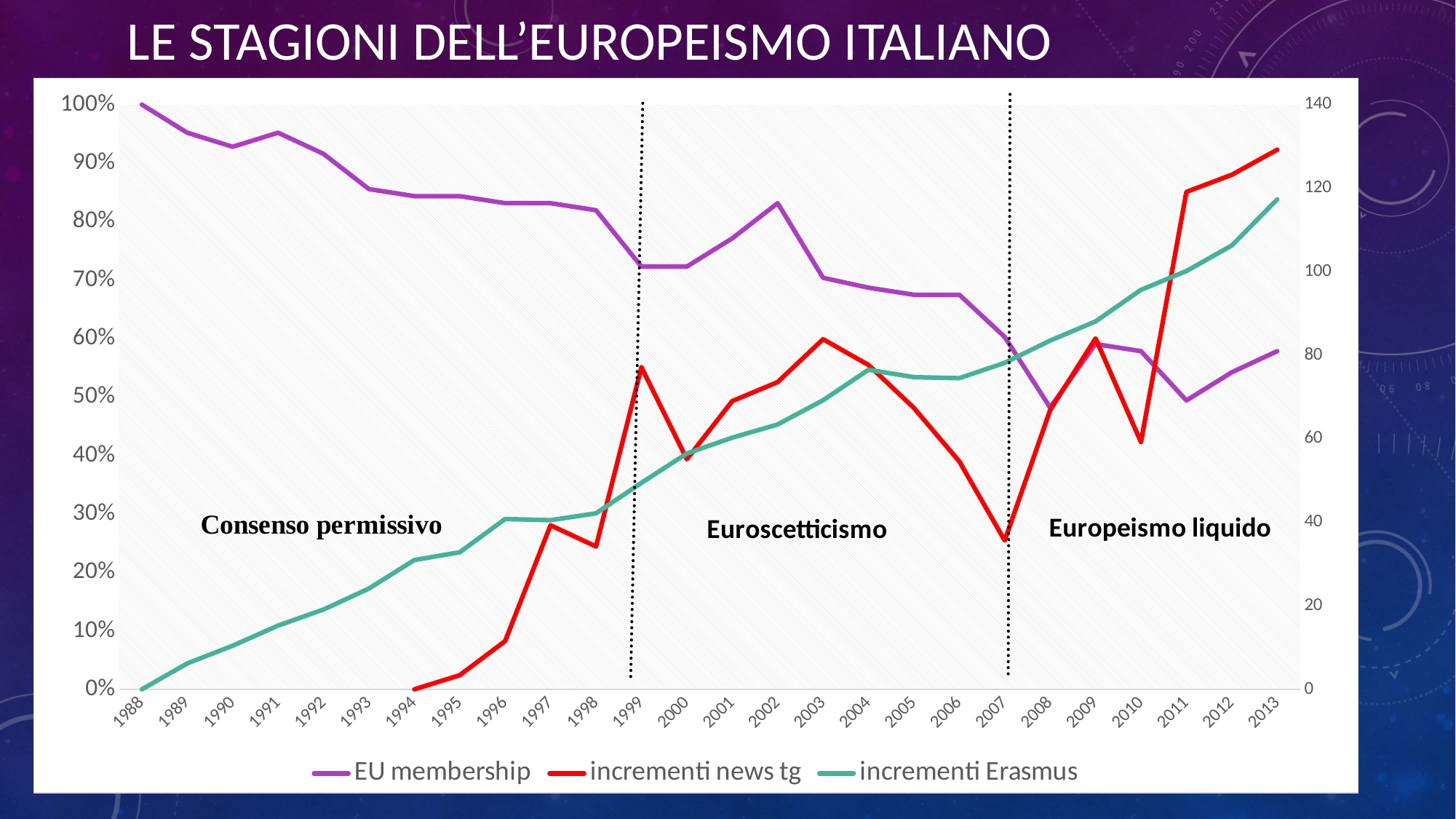
In which year is EU membership at its highest? 1988 What is the value of incrementi Erasmus in 1988 on the right axis? 0 Is the value for EU membership in 2007 greater or less than 70%? less What is the title of the chart on the slide? LE STAGIONI DELL'EUROPEISMO ITALIANO How many years are plotted along the x axis? 26 Which series has the higher value in 2013 on the right axis, incrementi news tg or incrementi Erasmus? incrementi news tg Does EU membership generally rise or fall from 1988 to 2013? fall Is the value for incrementi news tg in 2013 greater or less than 120? greater How many series does the legend list? 3 What kind of chart is shown on the slide? line chart What is the value of EU membership in 1988? 100% In which year is EU membership at its lowest? 2008